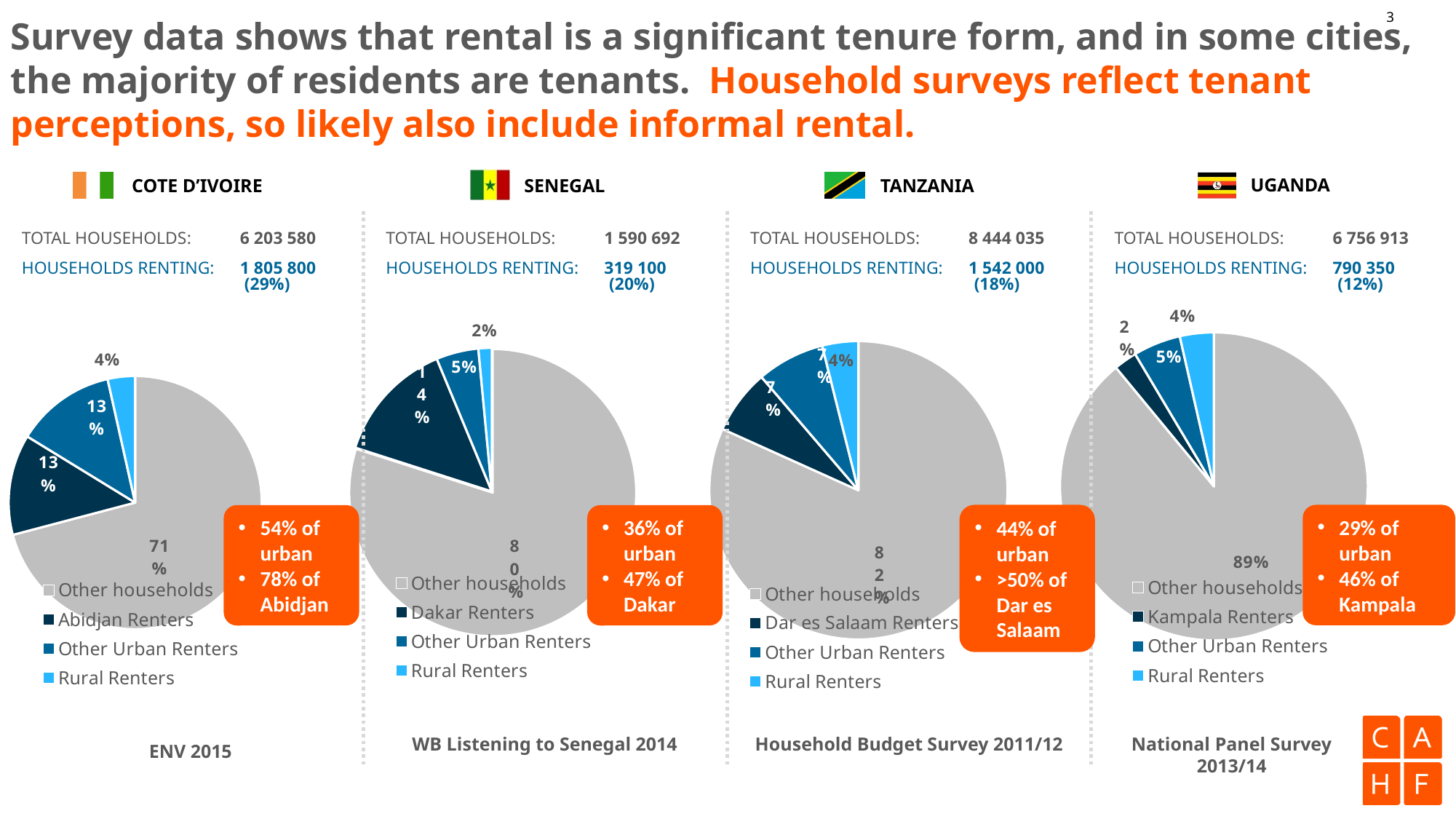
In the Uganda pie chart, which is larger: Other Urban Renters or Rural Renters? Other Urban Renters In the Senegal pie chart, what percentage is shown for Other Urban Renters? 5% In the Uganda pie chart, which category has the smallest slice? Kampala Renters How many categories does the legend of the Tanzania pie chart list? 4 What type of chart is used for Cote d'Ivoire? Pie chart In the Senegal pie chart, what percentage is shown for Dakar Renters? 14% What is the source label shown under the Tanzania pie chart? Household Budget Survey 2011/12 In the Cote d'Ivoire pie chart, what share of households is labelled as Other households? 71% In the Senegal pie chart, what is the difference between the Dakar Renters share and the Rural Renters share? 12% In the Uganda pie chart, what percentage is shown for Other households? 89% In the Cote d'Ivoire pie chart, what percentage is shown for Rural Renters? 4% In the Senegal pie chart, which category has the largest slice? Other households